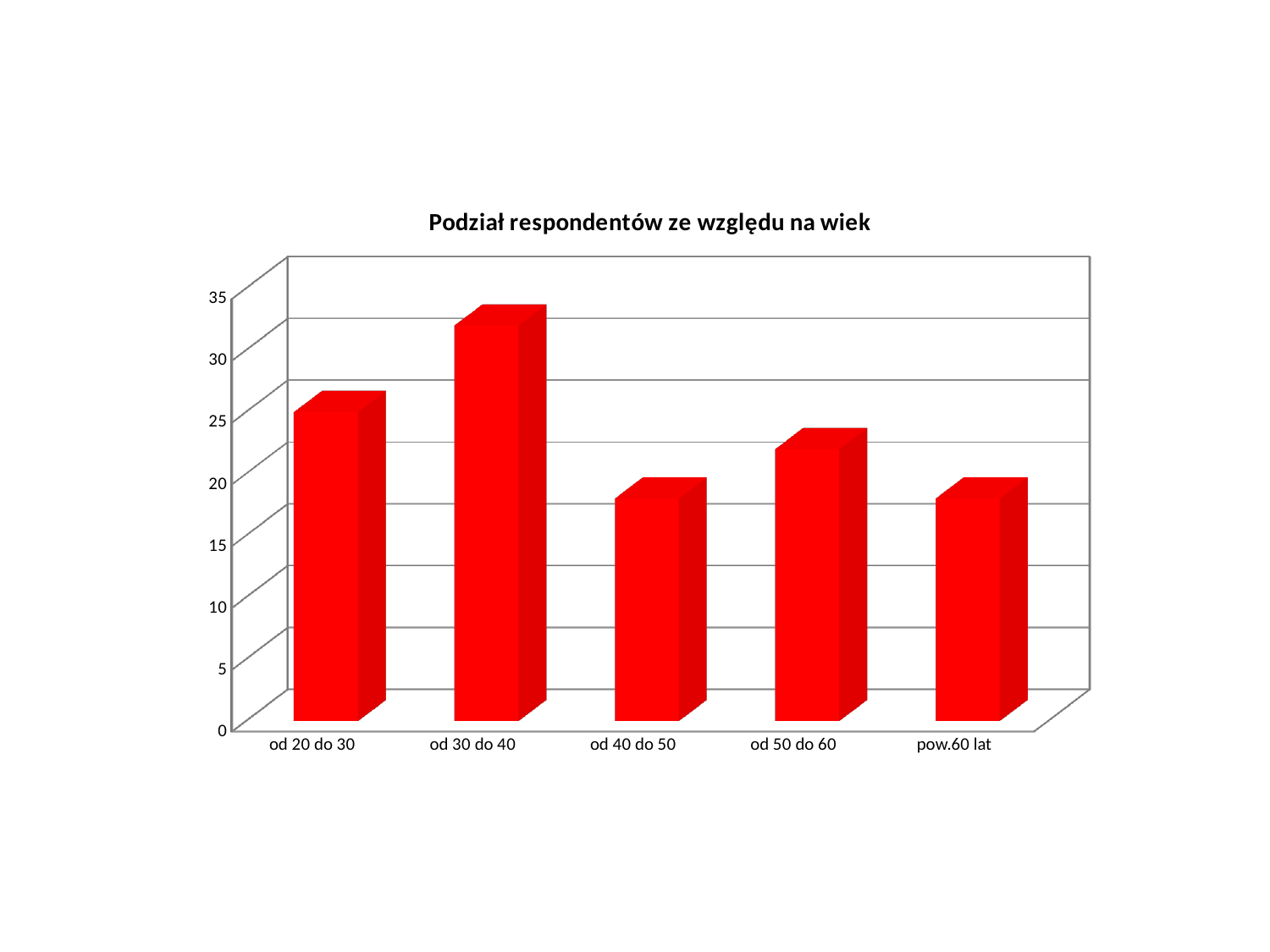
Is the value for od 30 do 40 greater or less than 30? greater Which age category has the highest value? od 30 do 40 What type of chart is shown on the slide? bar chart Which is larger, the value for od 20 do 30 or the value for od 50 do 60? od 20 do 30 Is the value for od 40 do 50 greater or less than 20? less Is the value for od 50 do 60 greater or less than 25? less How many age categories are shown on the x axis? 5 What is the title of the chart? Podział respondentów ze względu na wiek What colour are the bars in the chart? red Which is larger, the value for od 30 do 40 or the value for od 40 do 50? od 30 do 40